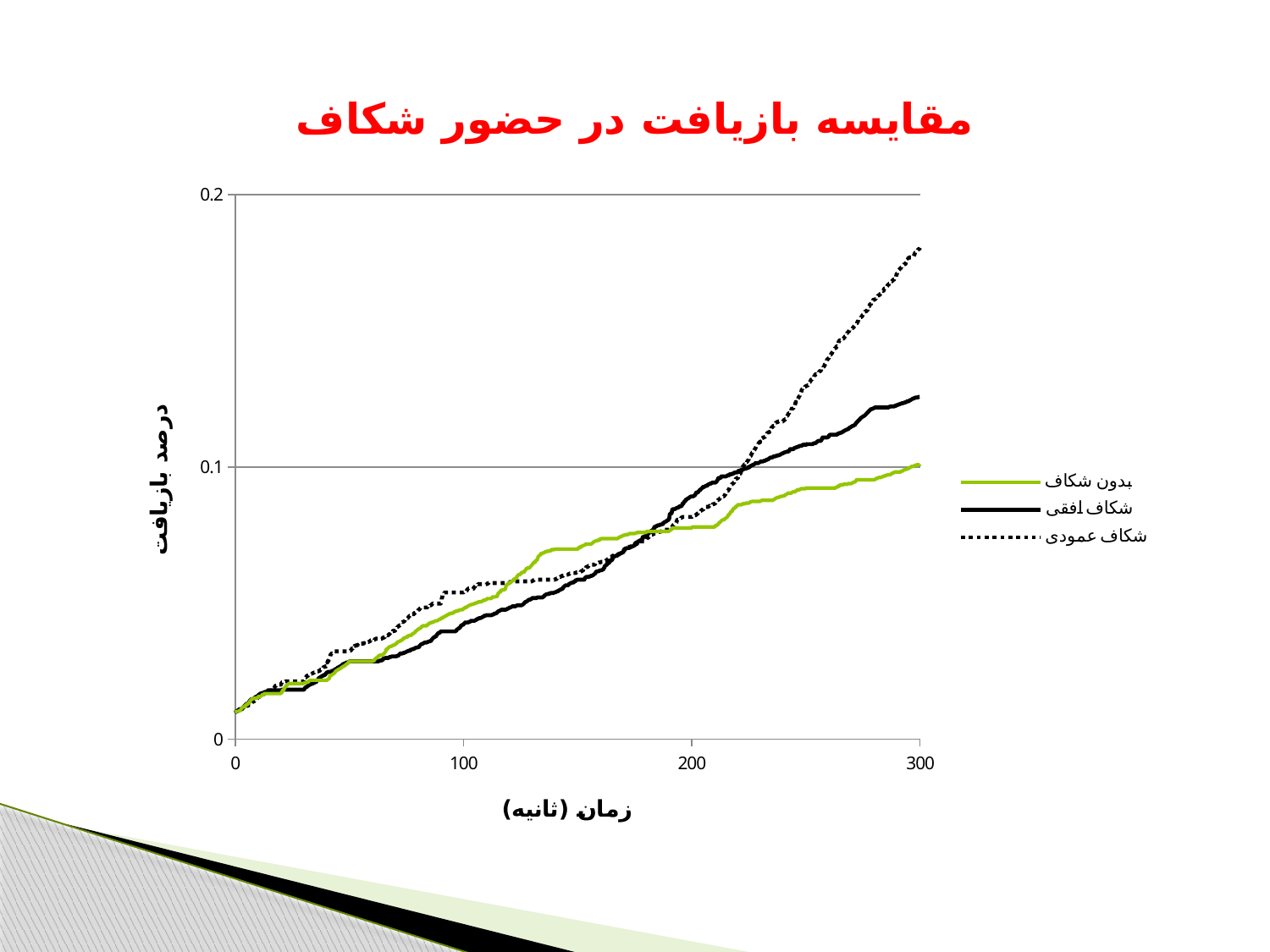
What kind of chart is shown on the slide? line chart What is the title of the chart? مقایسه بازیافت در حضور شکاف Do the values of the series rise or fall as time increases along the x axis? rise Is the value for شکاف عمودی at time 300 greater or less than 0.1? greater At time 300, which is larger: the value for شکاف عمودی or the value for بدون شکاف? شکاف عمودی How many series does the legend list? 3 Which series is drawn with a dotted line? شکاف عمودی Which series has the highest value at time 300? شکاف عمودی What is the highest value shown on the y axis? 0.2 Which series has the lowest value at time 300? بدون شکاف Is the value for شکاف افقی at time 300 greater or less than 0.1? greater Is the value for بدون شکاف at time 100 greater or less than 0.1? less